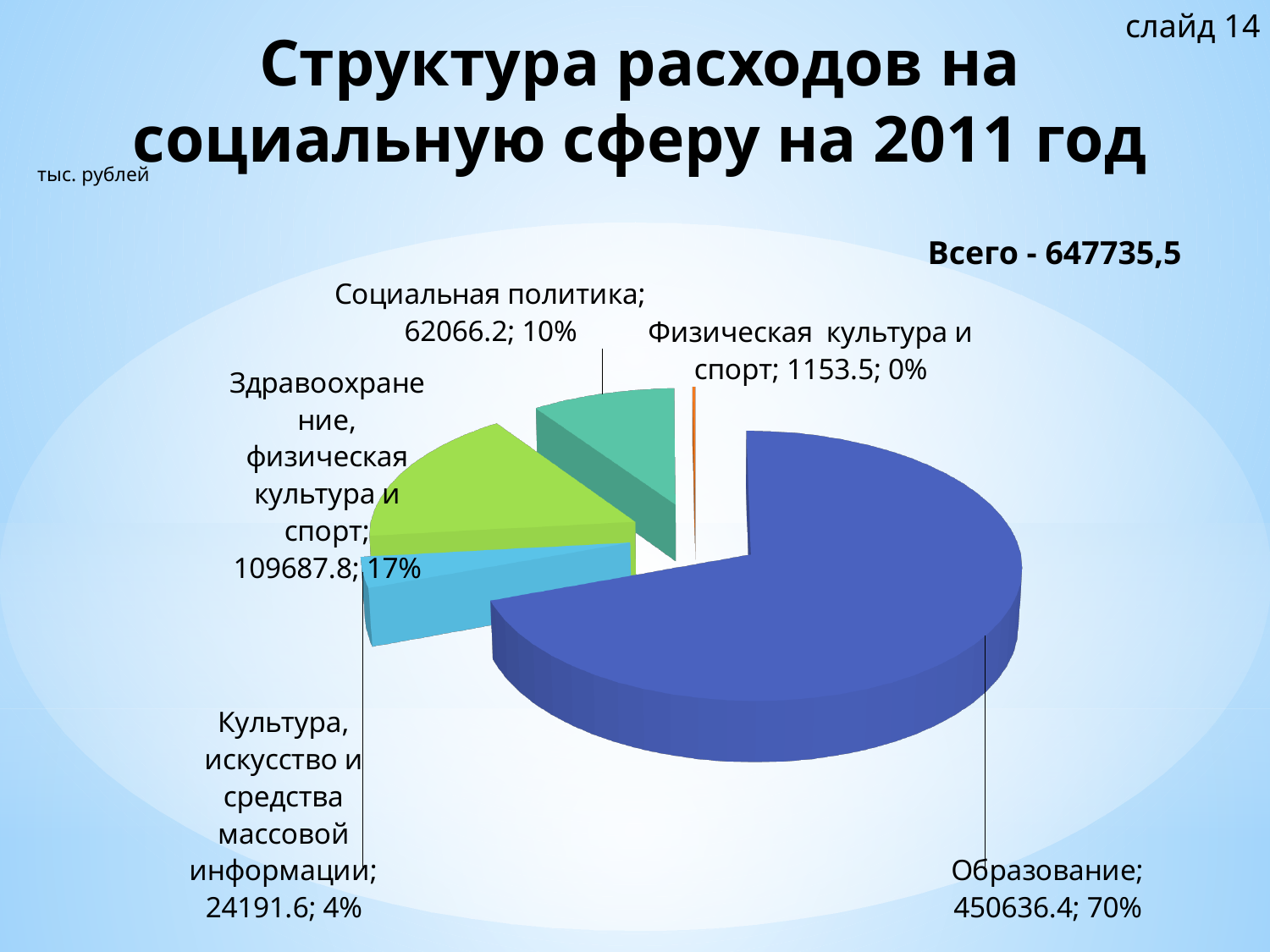
How many slices does the pie chart have? 5 What share of the pie does Образование represent? 70% What is the difference between the values for Здравоохранение, физическая культура и спорт and Социальная политика? 47621.6 What kind of chart is shown on the slide? Pie chart Which category has the largest slice? Образование What is the value for Социальная политика? 62066.2 What is the value for Культура, искусство и средства массовой информации? 24191.6 What share of the pie does Здравоохранение, физическая культура и спорт represent? 17% Which is larger, Социальная политика or Культура, искусство и средства массовой информации? Социальная политика What total (Всего) is stated on the slide? 647735,5 What is the value for Образование? 450636.4 Which category has the smallest slice? Физическая культура и спорт